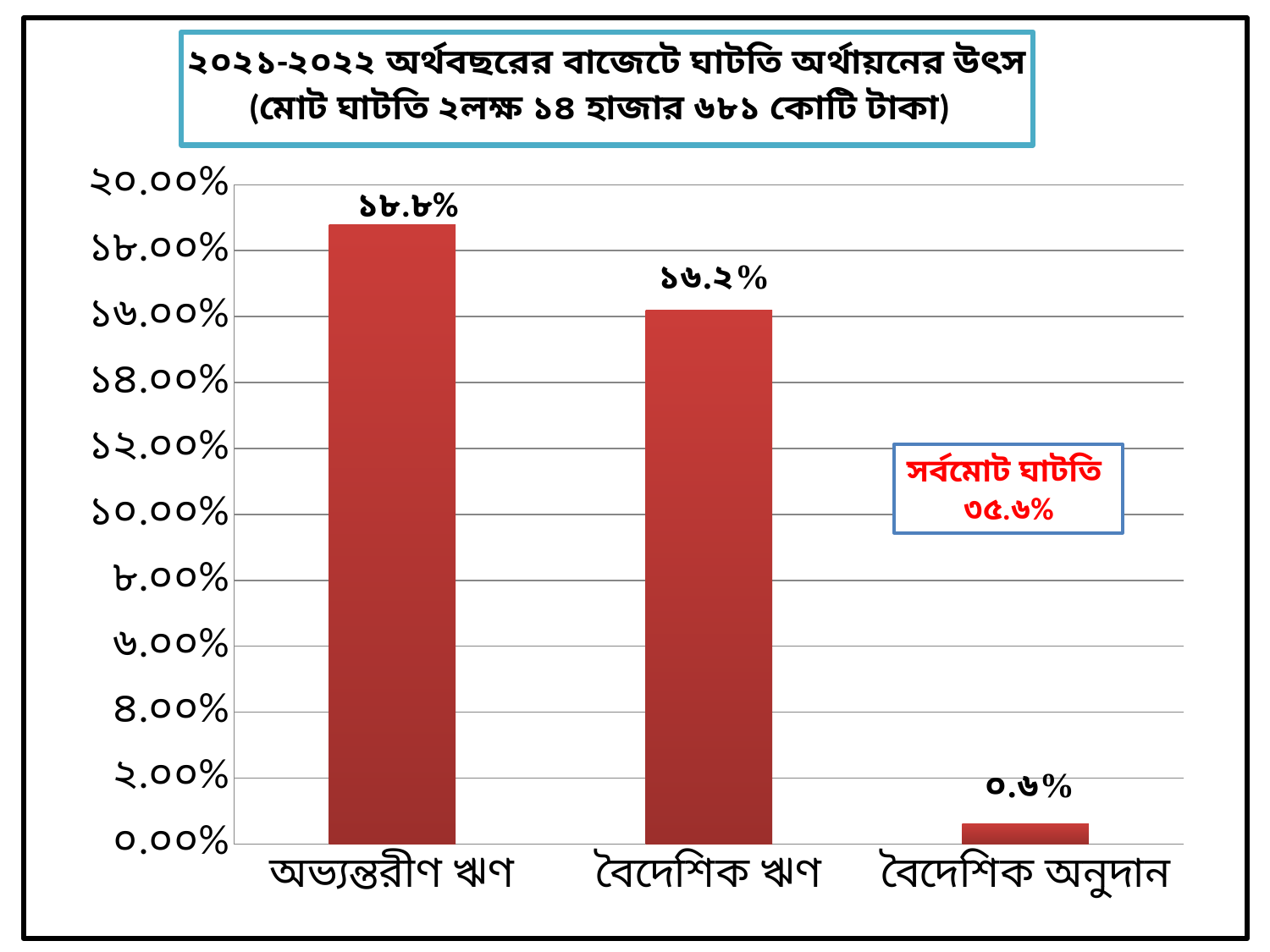
Which is larger, the value for বৈদেশিক ঋণ or the value for বৈদেশিক অনুদান? বৈদেশিক ঋণ Which category has the highest value? অভ্যন্তরীণ ঋণ What kind of chart is shown on the slide? bar chart What is the value for বৈদেশিক ঋণ? ১৬.২% What is the value for অভ্যন্তরীণ ঋণ? ১৮.৮% Is the value for বৈদেশিক ঋণ greater or less than ১৮.০০%? less What is the value for বৈদেশিক অনুদান? ০.৬% What is the difference between the values for বৈদেশিক ঋণ and বৈদেশিক অনুদান? ১৫.৬% Which category has the lowest value? বৈদেশিক অনুদান What is the difference between the values for অভ্যন্তরীণ ঋণ and বৈদেশিক ঋণ? ২.৬% How many categories are shown on the x axis? 3 What total deficit percentage is stated in the text box on the chart (সর্বমোট ঘাটতি)? ৩৫.৬%